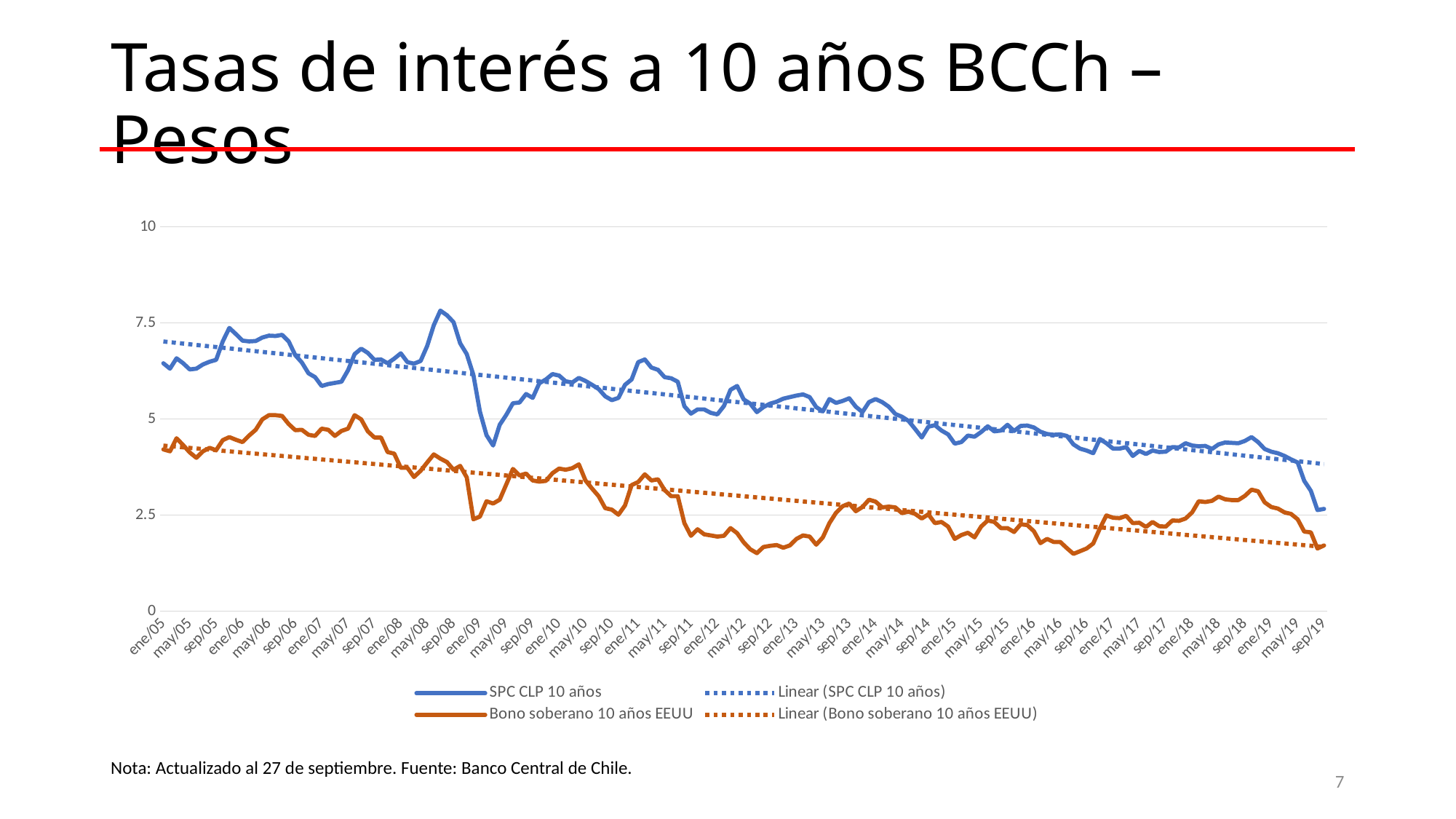
What kind of chart is shown on the slide? line chart Is the value of 'Bono soberano 10 años EEUU' at ene/05 greater or less than 5? less Is the value of 'SPC CLP 10 años' at ene/05 greater or less than 5? greater At ene/05, which series has the higher value: 'SPC CLP 10 años' or 'Bono soberano 10 años EEUU'? SPC CLP 10 años What colour is the line for the series 'SPC CLP 10 años'? blue How many entries does the chart legend list? 4 What is the title of the slide containing the chart? Tasas de interés a 10 años BCCh – Pesos Is the value of 'Bono soberano 10 años EEUU' at sep/12 greater or less than 2.5? less At sep/19, which series has the higher value: 'SPC CLP 10 años' or 'Bono soberano 10 años EEUU'? SPC CLP 10 años Overall, does the 'SPC CLP 10 años' series rise or fall from ene/05 to sep/19? fall